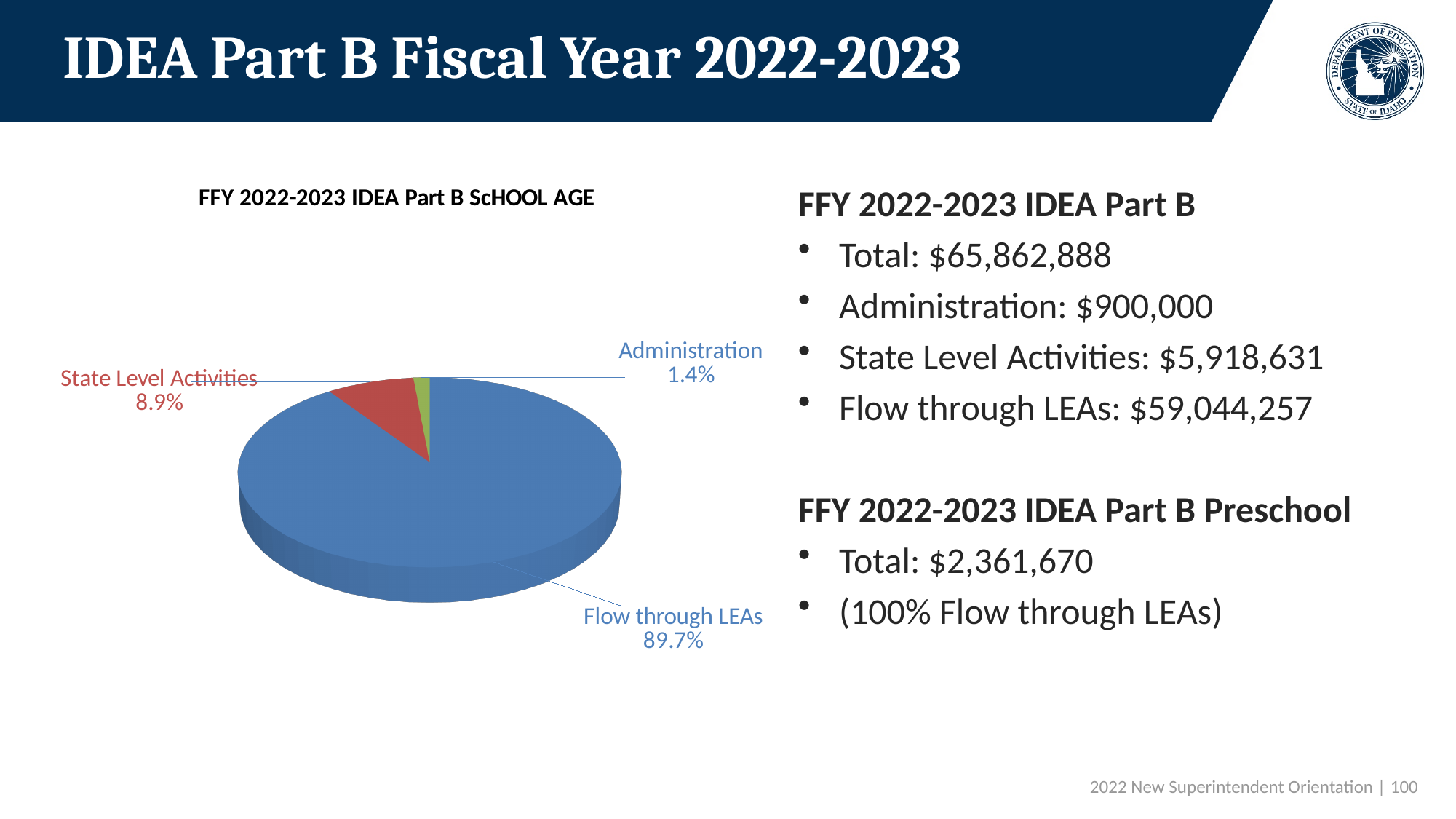
What type of chart is shown on the slide? Pie chart Which slice of the pie is the smallest? Administration What percentage of the pie is Flow through LEAs? 89.7% How many slices does the pie chart have? 3 Which is larger, the State Level Activities slice or the Administration slice? State Level Activities What is the title of the chart? FFY 2022-2023 IDEA Part B ScHOOL AGE What colour is the Flow through LEAs slice? Blue What percentage of the pie is State Level Activities? 8.9% Which slice of the pie is the largest? Flow through LEAs What is the difference in percentage points between the State Level Activities slice and the Administration slice? 7.5 What is the difference in percentage points between the Flow through LEAs slice and the State Level Activities slice? 80.8 What percentage of the pie is Administration? 1.4%